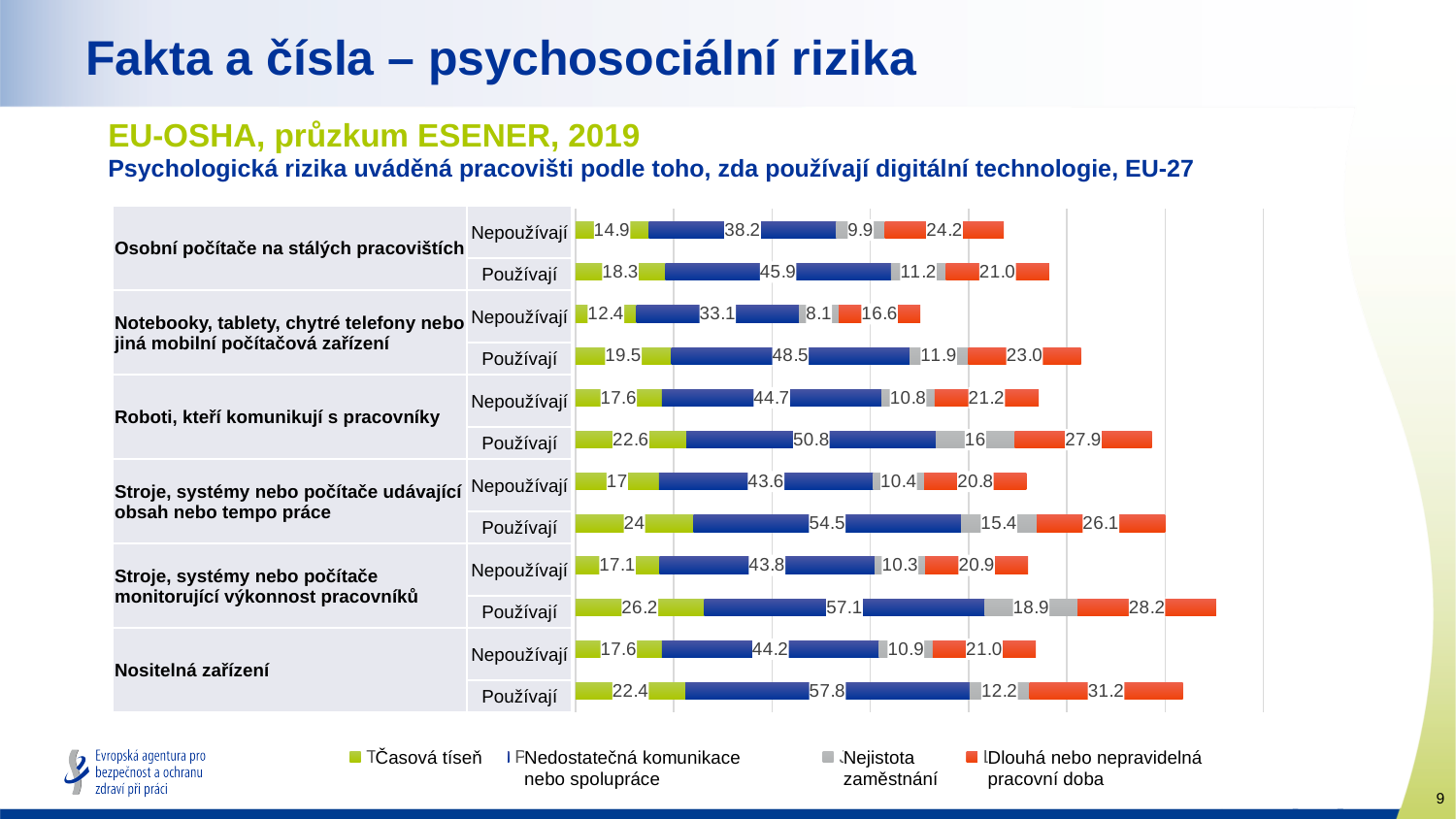
How many series does the legend list? 4 What is the total of the stacked bar for Stroje, systémy nebo počítače udávající obsah nebo tempo práce – Používají? 120 Which bar has the highest value for Nedostatečná komunikace nebo spolupráce? Nositelná zařízení – Používají What is the value of Časová tíseň for Nositelná zařízení – Používají? 22.4 What is the value of Nejistota zaměstnání for Roboti, kteří komunikují s pracovníky – Používají? 16 Which is larger: Dlouhá nebo nepravidelná pracovní doba for Osobní počítače na stálých pracovištích – Nepoužívají or for Osobní počítače na stálých pracovištích – Používají? Nepoužívají What is the value of Nedostatečná komunikace nebo spolupráce for Osobní počítače na stálých pracovištích – Nepoužívají? 38.2 Which bar has the lowest value for Časová tíseň? Notebooky, tablety, chytré telefony nebo jiná mobilní počítačová zařízení – Nepoužívají What is the value of Dlouhá nebo nepravidelná pracovní doba for Notebooky, tablety, chytré telefony nebo jiná mobilní počítačová zařízení – Nepoužívají? 16.6 What type of chart is shown on the slide? Stacked bar chart What is the difference in Časová tíseň between Používají and Nepoužívají for Stroje, systémy nebo počítače monitorující výkonnost pracovníků? 9.1 How many stacked bars are plotted in the chart? 12